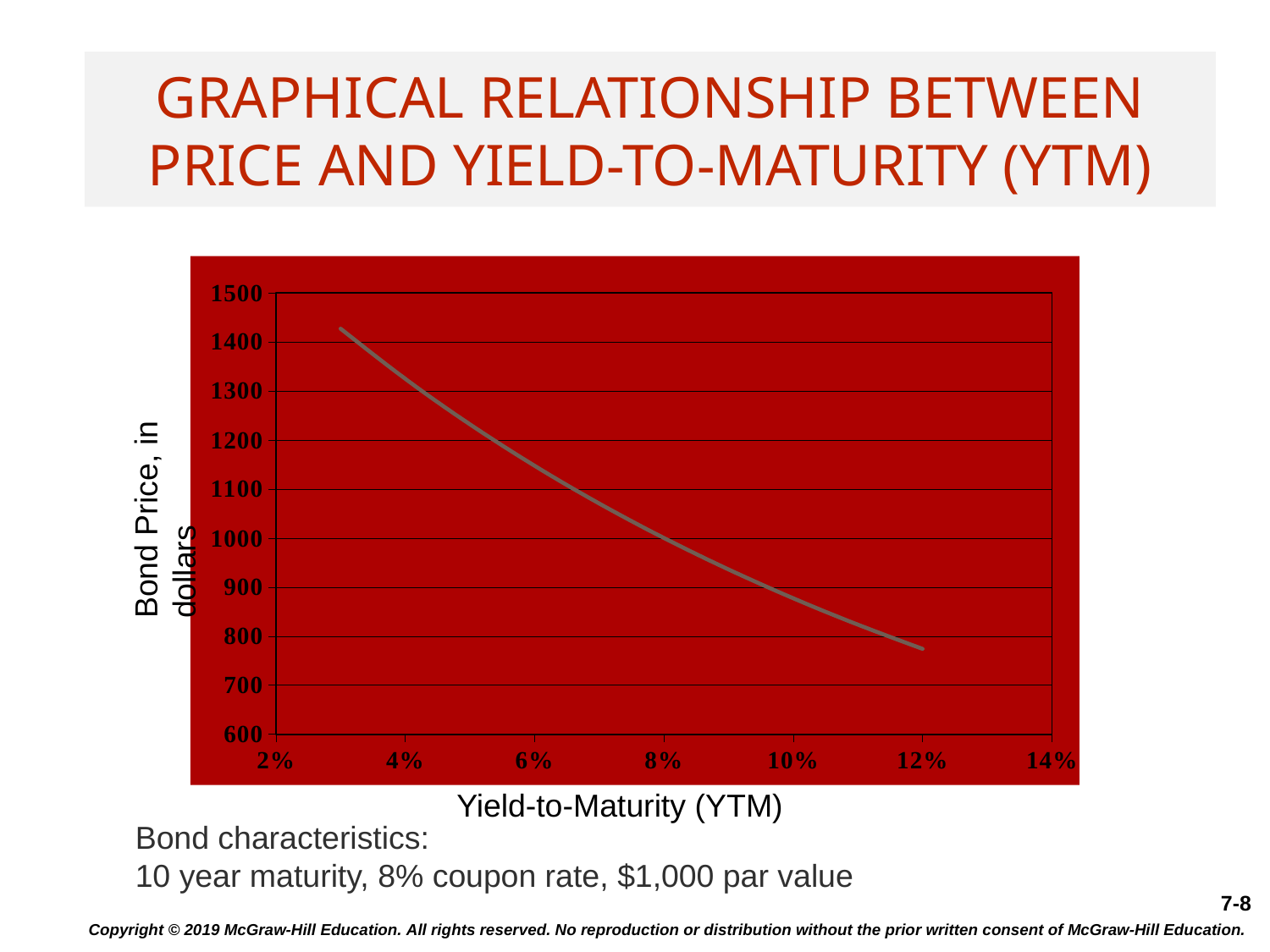
What is the highest value shown on the y axis? 1500 What is the label of the y axis? Bond Price, in dollars As yield-to-maturity increases along the x axis, does the bond price rise or fall? fall Is the bond price at an 8% yield-to-maturity greater or less than 1100? less Is the bond price at a 12% yield-to-maturity greater or less than 900? less What kind of chart is shown on the slide? line chart Is the bond price at a 10% yield-to-maturity greater or less than 1000? less Is the bond price higher at a 4% yield-to-maturity or at a 10% yield-to-maturity? 4% What is the label of the x axis? Yield-to-Maturity (YTM)